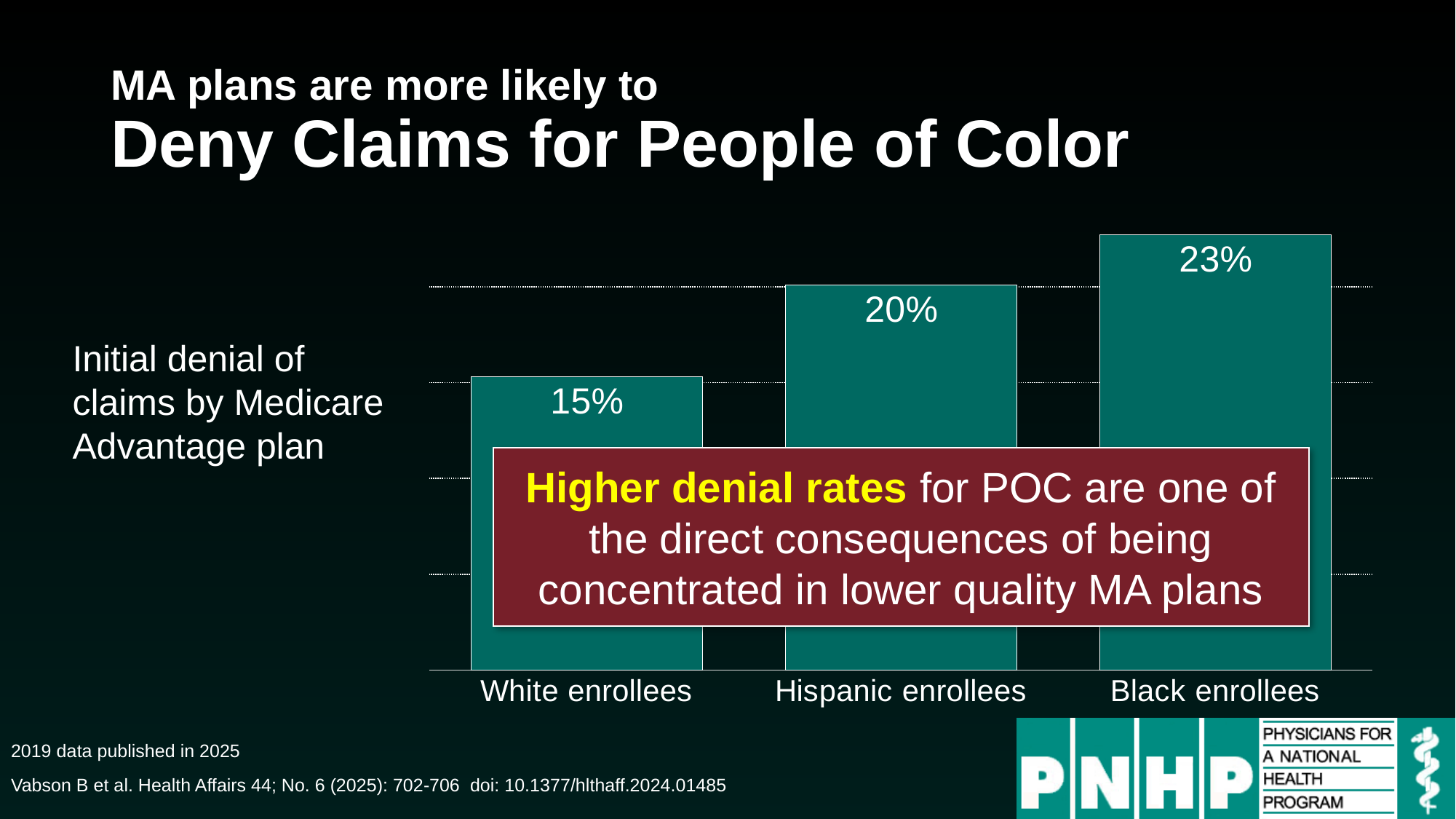
What is the initial denial rate for Hispanic enrollees? 20% Which enrollee group has the lowest denial rate? White enrollees What does the chart measure, according to the label to its left? Initial denial of claims by Medicare Advantage plan What is the initial denial rate for White enrollees? 15% Which enrollee group has the highest denial rate? Black enrollees What type of chart is shown on the slide? Bar chart Which group has a higher denial rate, Hispanic enrollees or Black enrollees? Black enrollees What is the initial denial rate for Black enrollees? 23% What is the difference in denial rate between Hispanic enrollees and White enrollees? 5% Do the denial rates rise or fall moving from White enrollees to Black enrollees along the x axis? Rise How many enrollee groups are shown in the chart? 3 What is the difference in denial rate between Black enrollees and White enrollees? 8%